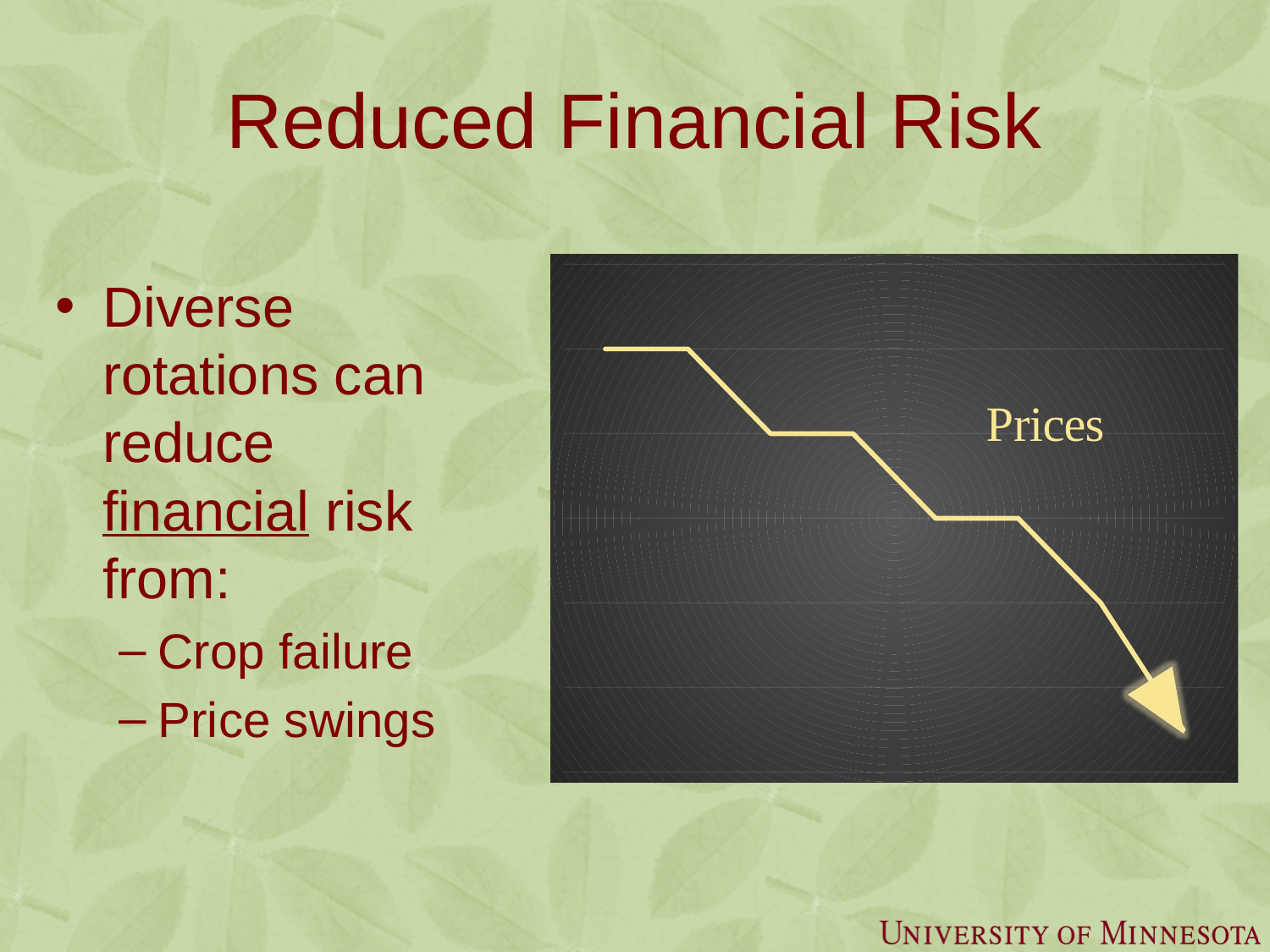
Do the values in the chart rise or fall from left to right? fall What kind of chart is shown on the right side of the slide? line chart What label is written on the chart next to the line? Prices What colour is the line plotted on the chart? yellow